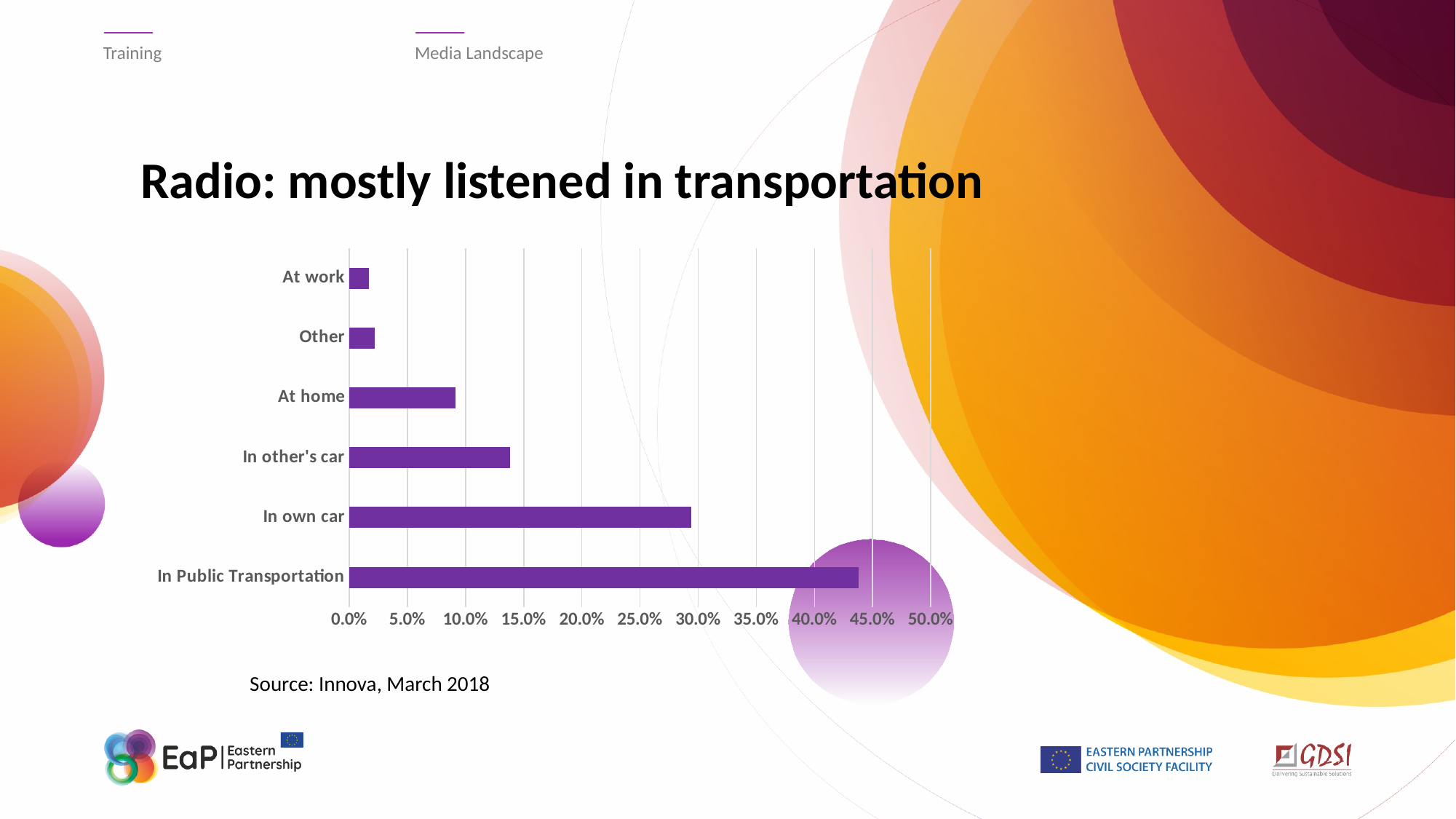
Which is larger, the value for In own car or the value for In other's car? In own car Is the value for In Public Transportation greater or less than 40.0%? greater Is the value for In own car greater or less than 25.0%? greater What source is cited below the chart? Innova, March 2018 What kind of chart is shown on the slide? bar chart Which is larger, the value for At home or the value for Other? At home Is the value for In other's car greater or less than 10.0%? greater How many categories are shown in the chart? 6 Which category has the highest value in the chart? In Public Transportation What is the title of the slide containing the chart? Radio: mostly listened in transportation